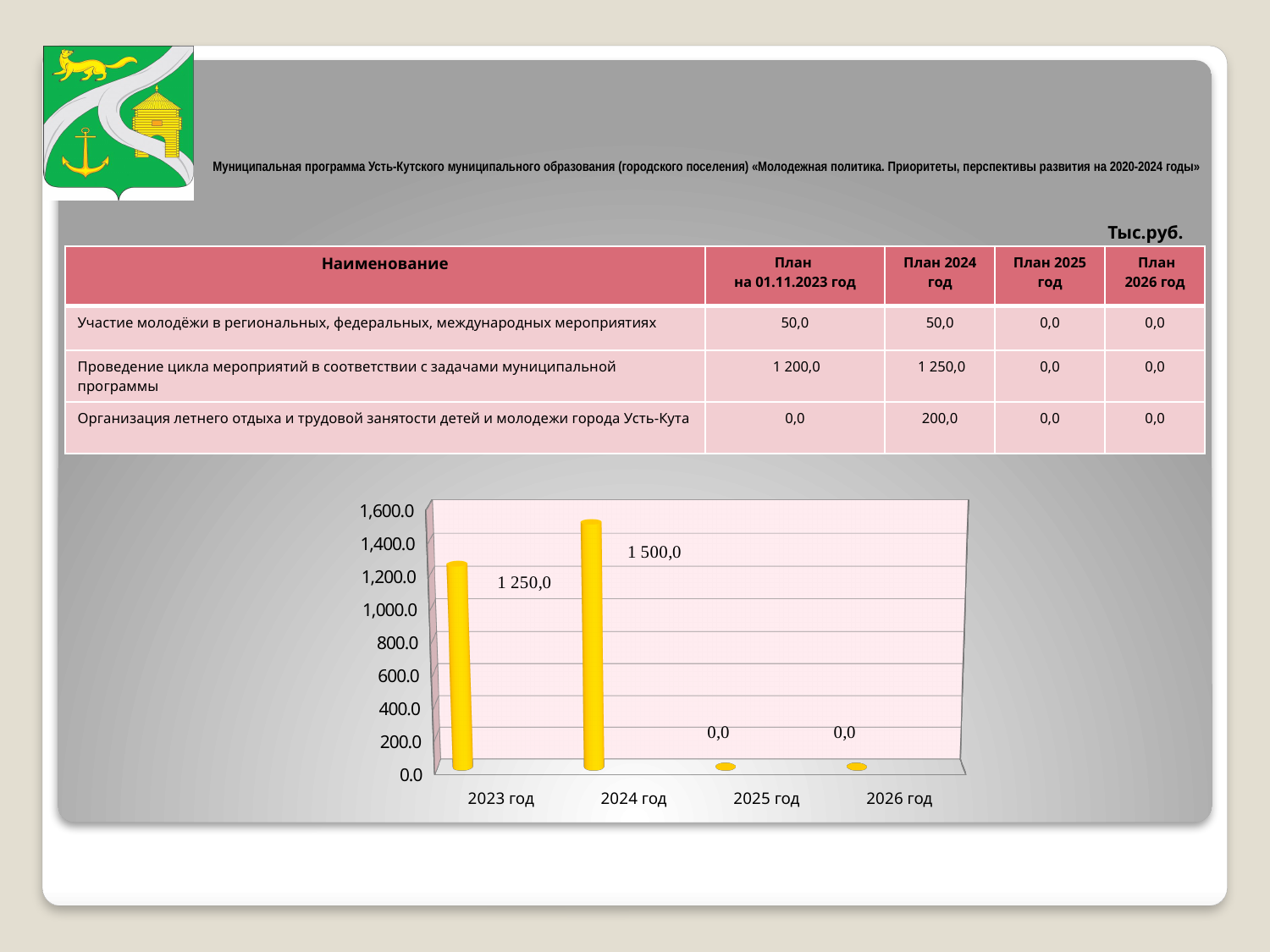
What is the value for 2026 год in the chart? 0,0 What is the value for 2024 год in the chart? 1 500,0 How many categories are shown on the x axis of the chart? 4 What is the value for 2025 год in the chart? 0,0 What kind of chart is shown on the slide? bar chart Is the value for 2023 год in the chart greater or less than 1,000.0? greater What is the highest tick value shown on the vertical axis of the chart? 1,600.0 Which is larger in the chart, the value for 2023 год or the value for 2024 год? 2024 год Is the value for 2024 год in the chart greater or less than 1,600.0? less Which year has the highest value in the chart? 2024 год What is the difference between the values for 2024 год and 2023 год in the chart? 250,0 What is the value for 2023 год in the chart? 1 250,0